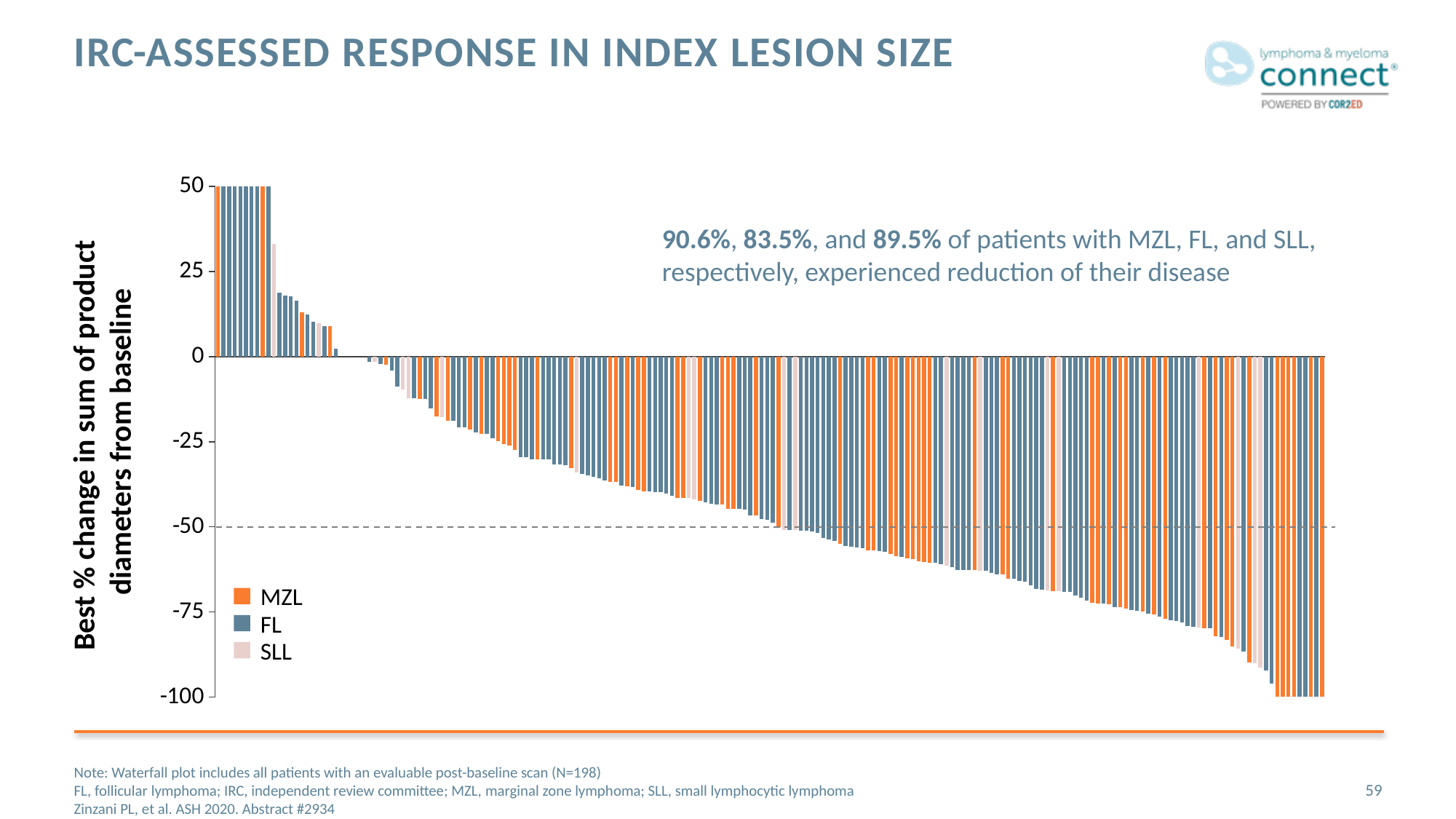
What kind of chart is shown on the slide? Bar chart Is the value of the rightmost bar greater or less than -75? less Which is larger, the value of the leftmost bar or the value of the rightmost bar? The leftmost bar What is the label of the y axis? Best % change in sum of product diameters from baseline How many series does the legend list? 3 Is the value of the leftmost bar greater or less than 25? greater At what y-axis value is the horizontal dashed reference line drawn? -50 Do the bar values rise or fall from left to right along the x axis? Fall What is the lowest value shown by any bar? -100 Which series are listed in the legend? MZL, FL, SLL What value do the rightmost bars reach on the y axis? -100